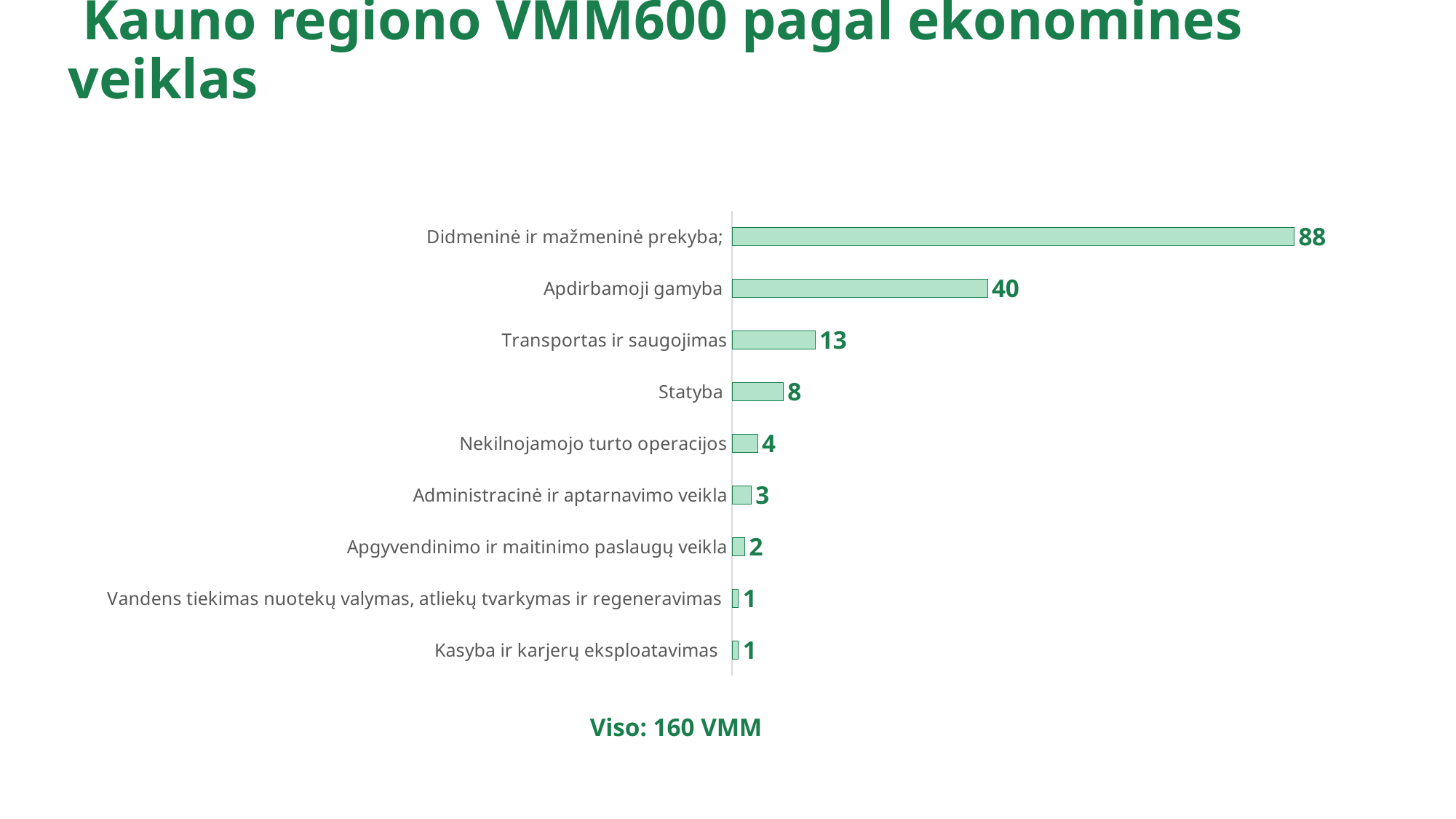
Which is larger, the value for Statyba or the value for Transportas ir saugojimas? Transportas ir saugojimas What is the difference between the values for Didmeninė ir mažmeninė prekyba and Apdirbamoji gamyba? 48 What is the value for Statyba? 8 What total is stated below the chart? Viso: 160 VMM What is the difference between the values for Administracinė ir aptarnavimo veikla and Apgyvendinimo ir maitinimo paslaugų veikla? 1 What is the value for Transportas ir saugojimas? 13 What kind of chart is shown on the slide? Bar chart What is the value for Nekilnojamojo turto operacijos? 4 What is the value for Didmeninė ir mažmeninė prekyba? 88 How many categories are shown in the chart? 9 Which category has the highest value? Didmeninė ir mažmeninė prekyba What is the value for Apdirbamoji gamyba? 40